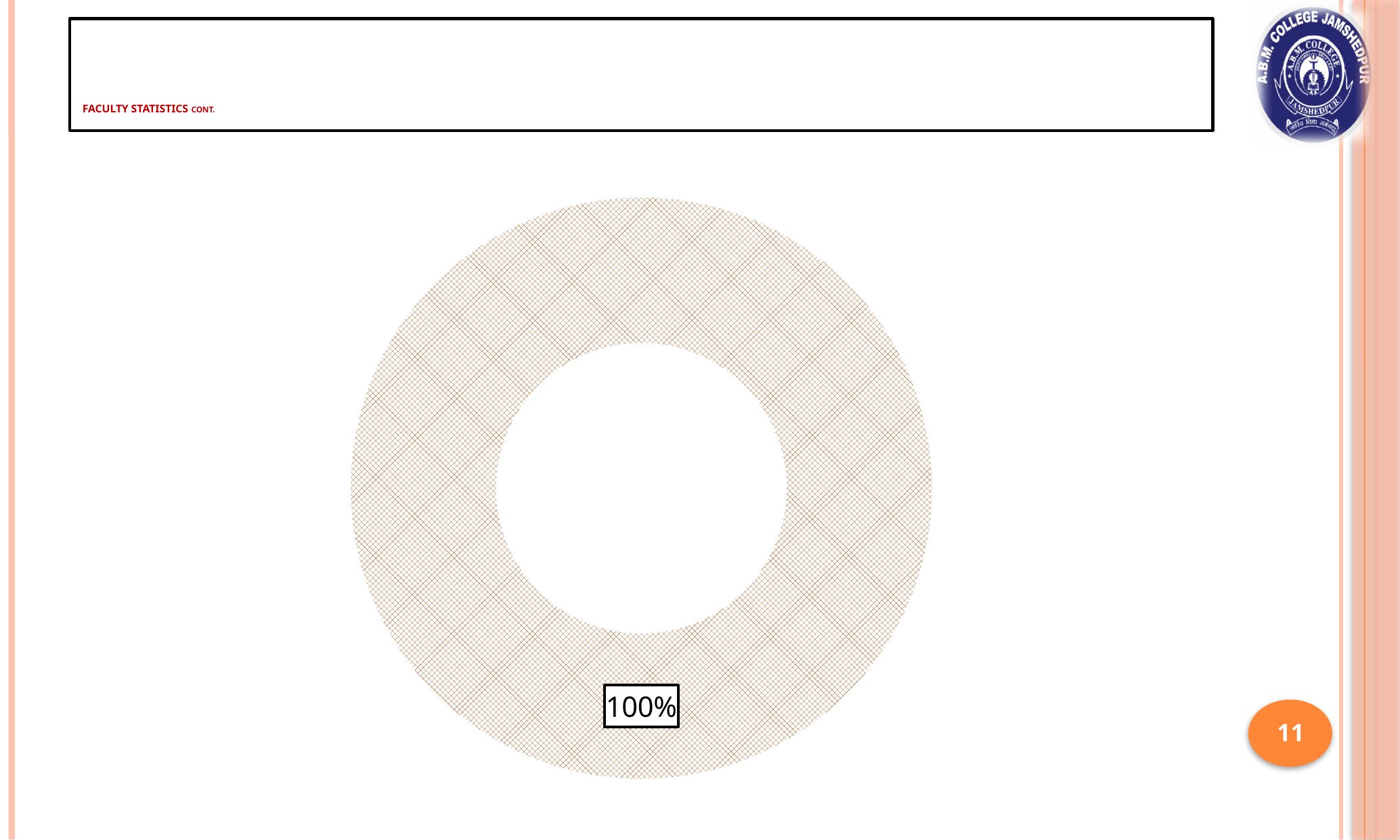
What share of the doughnut chart does the single slice take up? 100% Does the doughnut chart display a legend? No What percentage is printed on the data label of the doughnut chart? 100% How many slices does the doughnut chart have? 1 What is the title text shown at the top of the slide? FACULTY STATISTICS CONT. What kind of chart is shown on the slide? Doughnut chart